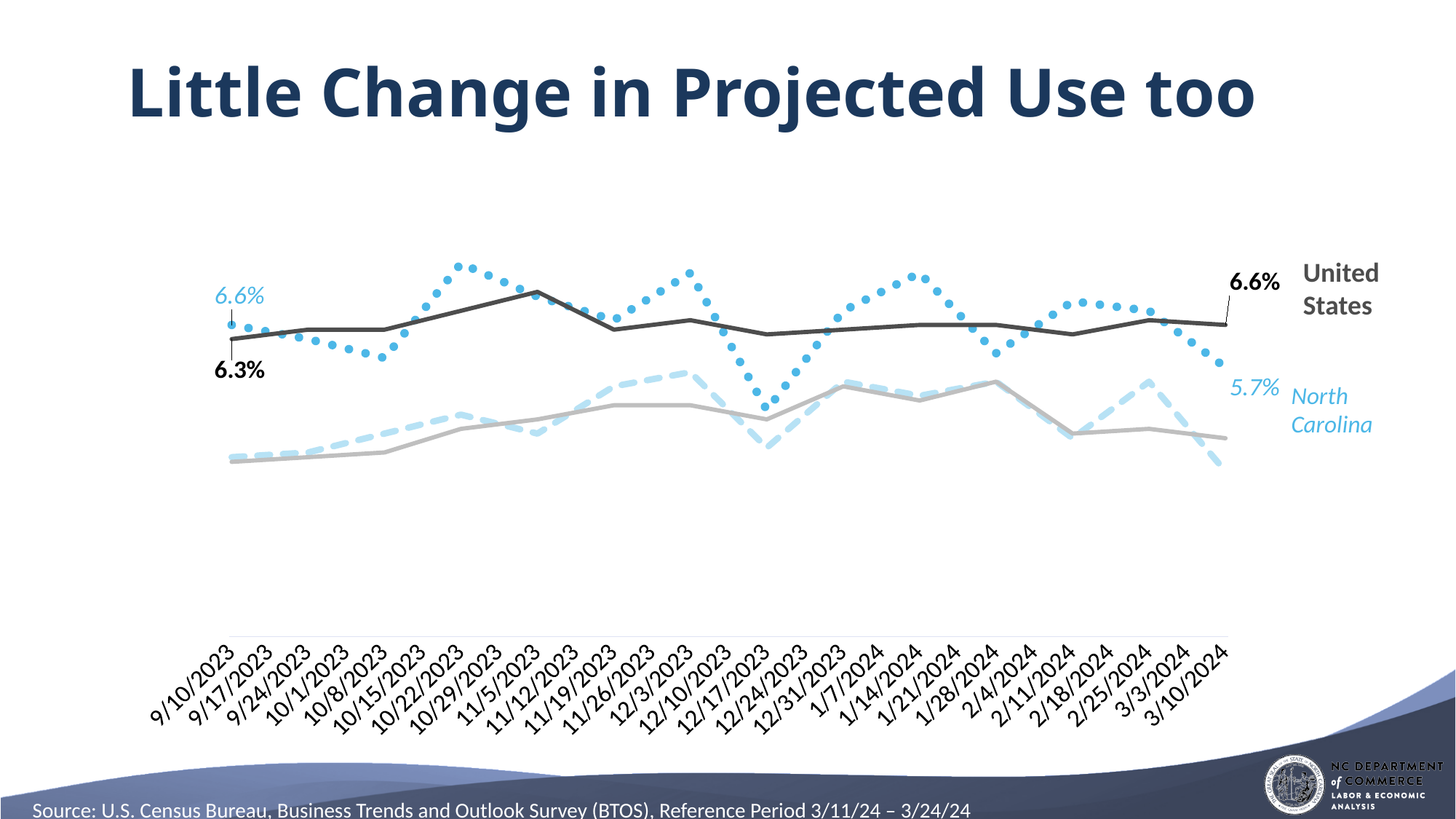
By how many percentage points did the United States value change from 9/10/2023 to 3/10/2024? 0.3 percentage points What is the North Carolina value at 9/10/2023? 6.6% At 9/10/2023, which is larger: the United States value or the North Carolina value? North Carolina What kind of chart is shown on the slide? line chart Does the North Carolina line end higher or lower than it starts? lower By how many percentage points did the North Carolina value change from 9/10/2023 to 3/10/2024? 0.9 percentage points How many dates are shown on the x axis? 27 What is the title of the chart on the slide? Little Change in Projected Use too What is the United States value at 3/10/2024? 6.6% What is the North Carolina value at 3/10/2024? 5.7% What is the United States value at 9/10/2023? 6.3% At 3/10/2024, which is larger: the United States value or the North Carolina value? United States